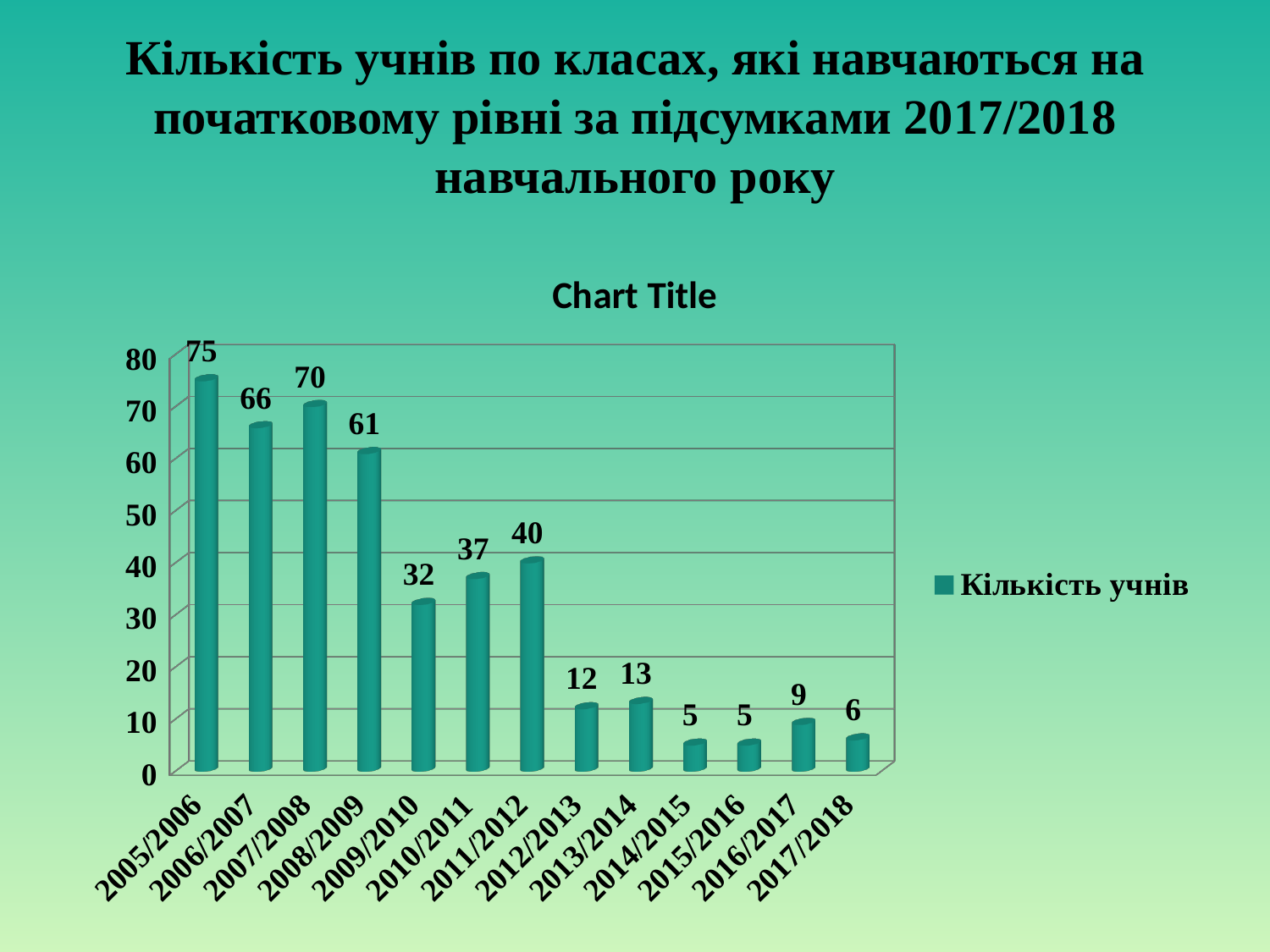
Is the value for 2009/2010 greater or less than 40? less How many series does the legend list? 1 Do the values generally rise or fall from 2005/2006 to 2017/2018? fall What is the value for 2011/2012? 40 What is the value for 2005/2006? 75 What is the legend entry for the series? Кількість учнів What kind of chart is shown? bar chart How many categories are shown on the x axis? 13 What is the value for 2017/2018? 6 What is the difference between the values for 2007/2008 and 2008/2009? 9 Which category has the highest value? 2005/2006 Which is larger, the value for 2012/2013 or the value for 2013/2014? 2013/2014